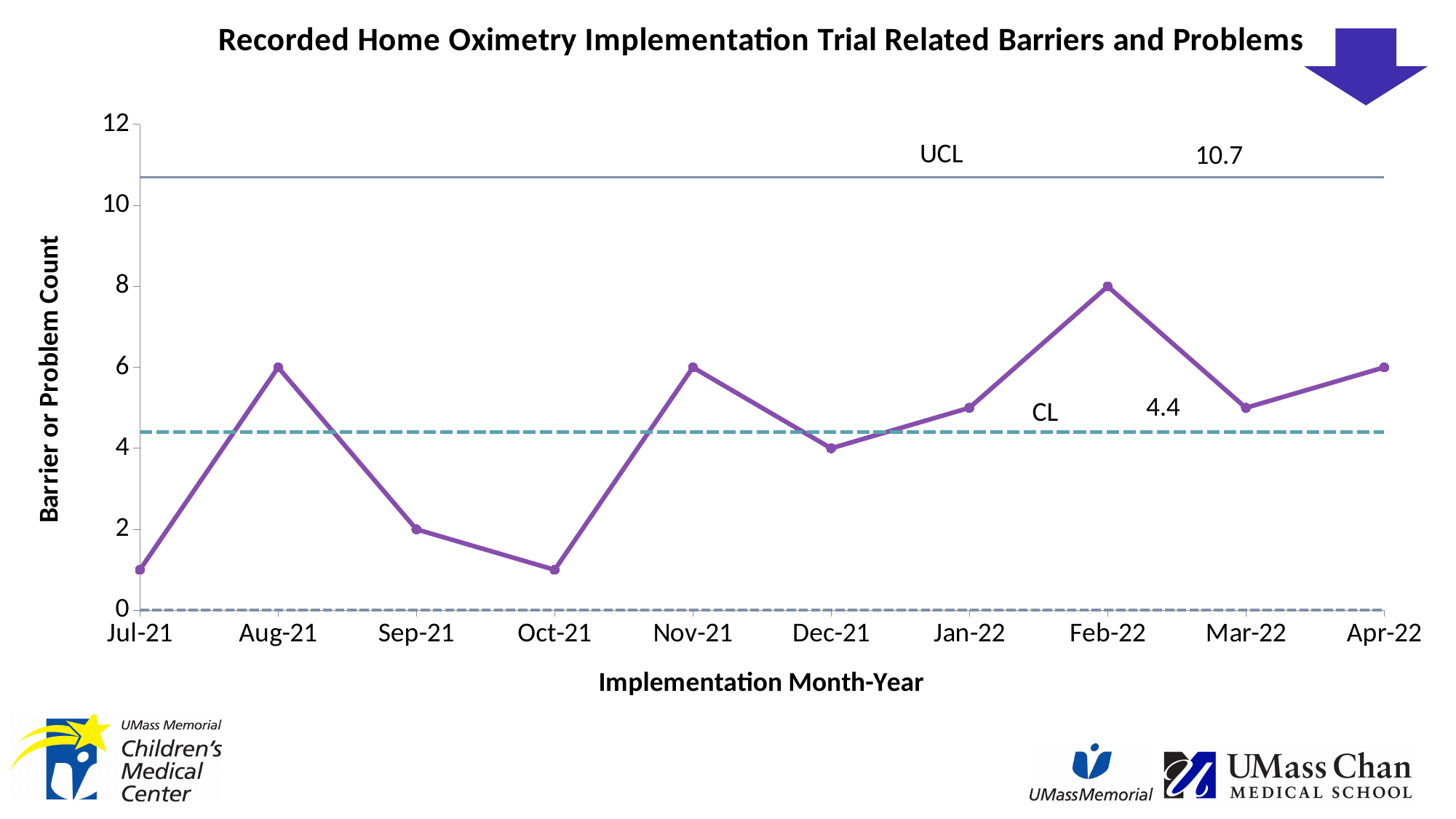
What is the barrier or problem count for Dec-21? 4 How many months are plotted on the x axis? 10 Which month has the highest barrier or problem count? Feb-22 What kind of chart is shown on the slide? line chart Is the barrier or problem count for Oct-21 greater or less than 2? less What is the barrier or problem count for Feb-22? 8 Is the barrier or problem count for Jan-22 greater or less than 4? greater What is the difference between the barrier or problem count for Feb-22 and Sep-21? 6 Which month has a larger barrier or problem count, Aug-21 or Sep-21? Aug-21 What is the barrier or problem count for Sep-21? 2 Does the barrier or problem count rise or fall from Sep-21 to Oct-21? fall What is the value of the UCL line shown on the chart? 10.7